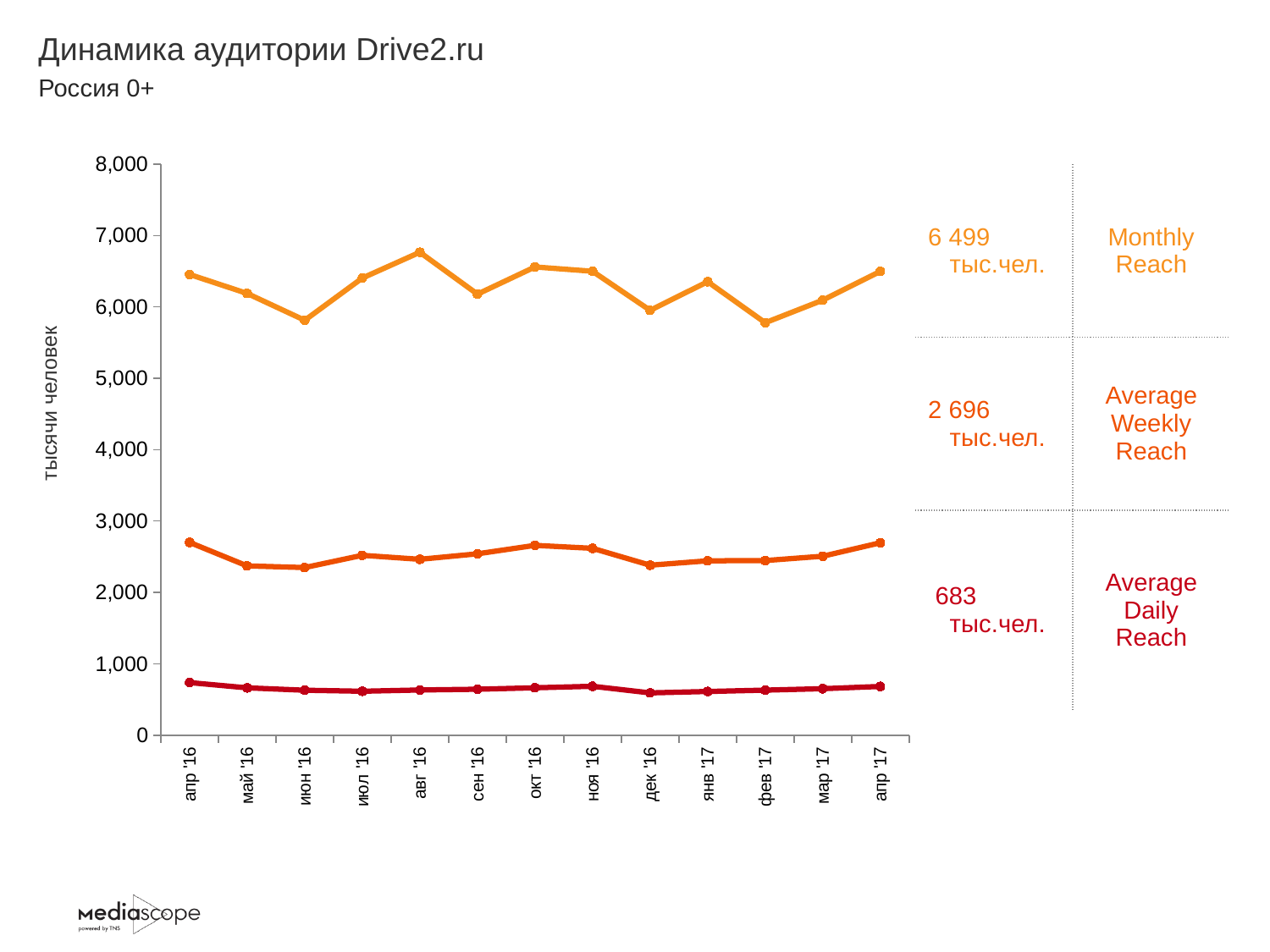
Is the Average Daily Reach value for апр '16 greater or less than 1,000? less In which month is Monthly Reach highest? авг '16 What Average Daily Reach value is printed on the slide? 683 тыс.чел. Is the Monthly Reach value for июн '16 greater or less than 6,000? less Which is larger, the Monthly Reach for апр '16 or for май '16? апр '16 How many series are shown in the chart? 3 Is the Monthly Reach value for авг '16 greater or less than 6,000? greater What Monthly Reach value is printed on the slide? 6 499 тыс.чел. What is the difference between the printed Monthly Reach and Average Weekly Reach values? 3 803 тыс.чел. How many months are plotted along the x axis? 13 What Average Weekly Reach value is printed on the slide? 2 696 тыс.чел. What kind of chart is shown on the slide? line chart